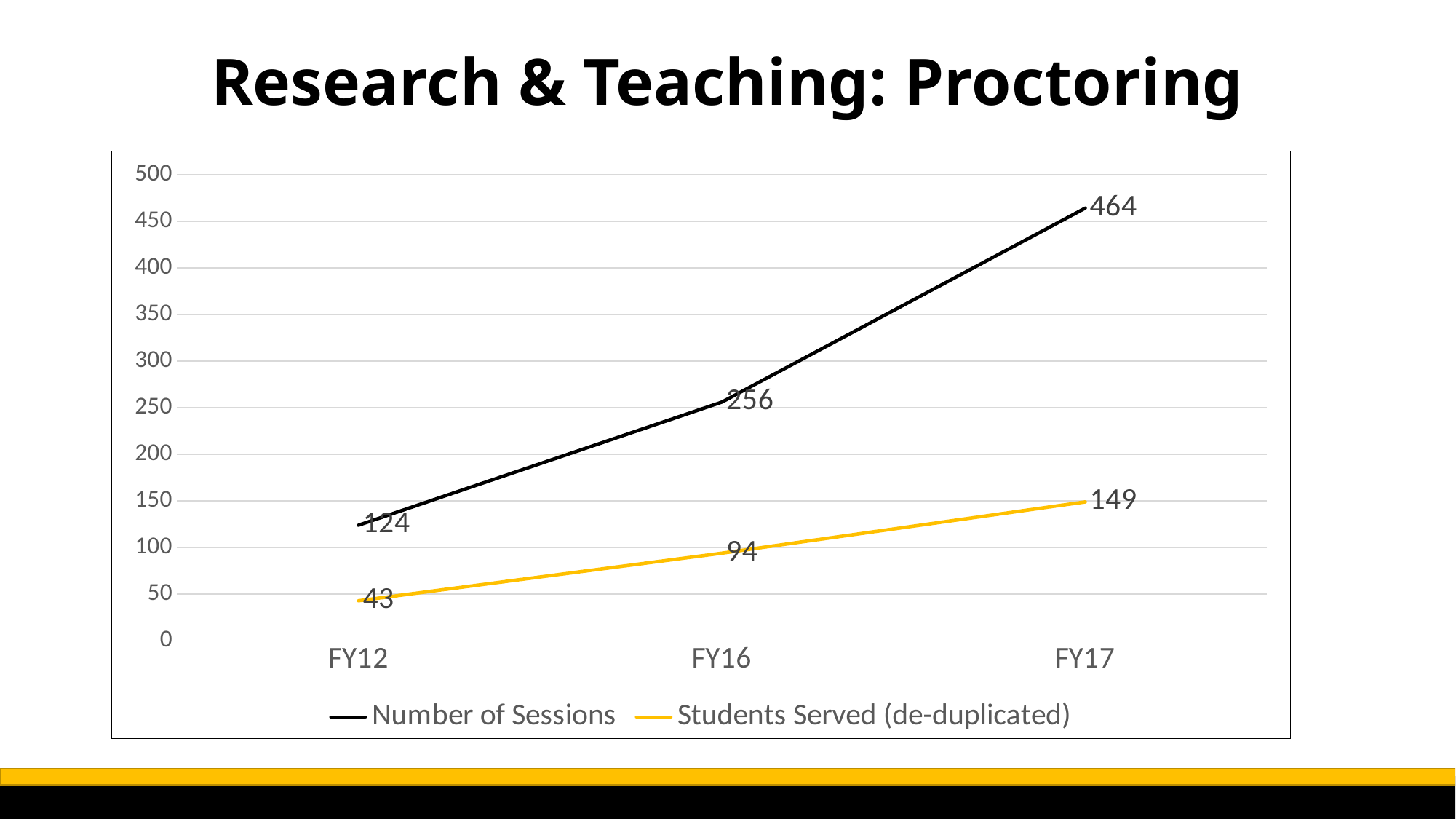
How many fiscal years are shown on the x axis? 3 In which fiscal year is Students Served (de-duplicated) lowest? FY12 What is the difference between the Number of Sessions in FY17 and FY12? 340 In which fiscal year is the Number of Sessions highest? FY17 Which is larger in FY17: Number of Sessions or Students Served (de-duplicated)? Number of Sessions How many series does the legend list? 2 What is the Number of Sessions in FY17? 464 What kind of chart is shown on the slide? Line chart What is the difference between Number of Sessions and Students Served (de-duplicated) in FY16? 162 What is the value for Students Served (de-duplicated) in FY12? 43 What is the value for Students Served (de-duplicated) in FY16? 94 What is the Number of Sessions in FY16? 256